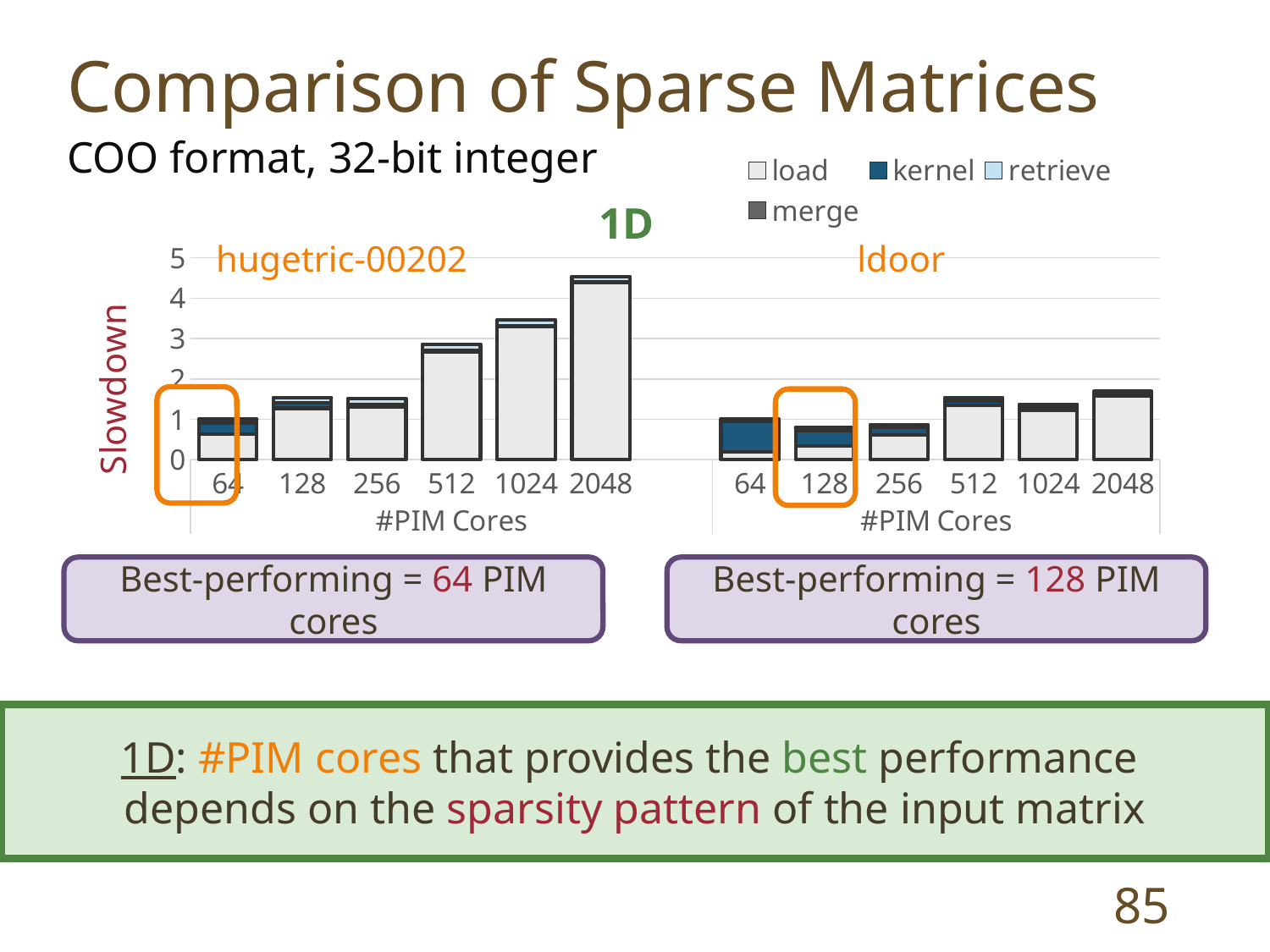
For hugetric-00202, does the slowdown generally rise or fall as #PIM Cores increases from 64 to 2048? rise Which has the larger slowdown at 2048 PIM cores: hugetric-00202 or ldoor? hugetric-00202 For the ldoor matrix, which #PIM Cores value has the lowest slowdown? 128 How many series does the legend list? 4 What is the label of the y axis? Slowdown For the hugetric-00202 matrix, which #PIM Cores value has the highest slowdown? 2048 Is the slowdown for ldoor at 512 PIM cores greater or less than 2? less Is the slowdown for hugetric-00202 at 1024 PIM cores greater or less than 3? greater What kind of chart is shown on the slide? stacked bar chart Is the slowdown for hugetric-00202 at 2048 PIM cores greater or less than 4? greater How many #PIM Cores categories are plotted for the hugetric-00202 matrix? 6 For the hugetric-00202 matrix, which #PIM Cores value has the lowest slowdown? 64